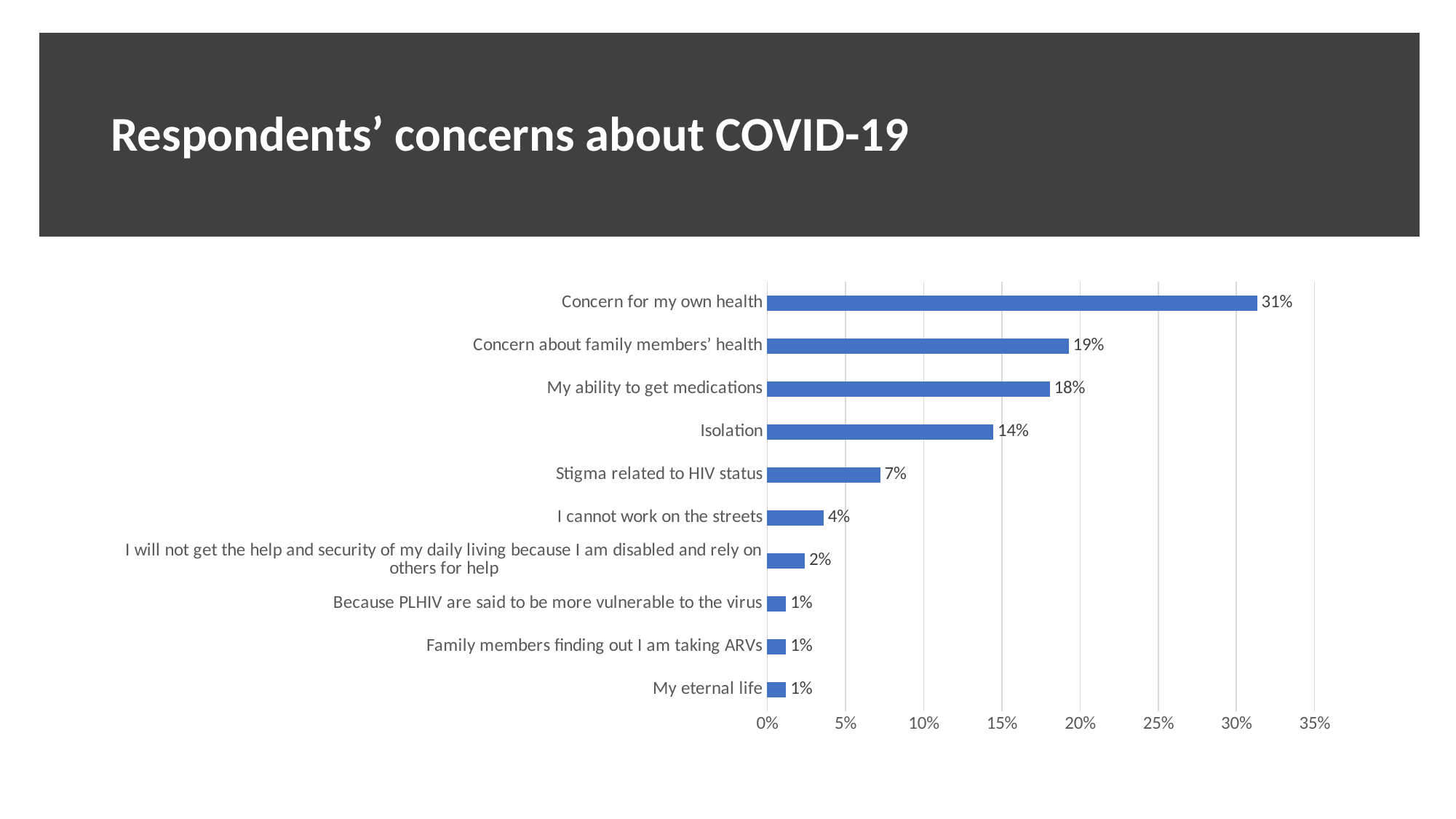
What is the value for 'Isolation'? 14% What is the difference between 'Concern for my own health' and 'Concern about family members' health'? 12% What type of chart is shown on the slide? Bar chart Which is larger: 'Stigma related to HIV status' or 'I cannot work on the streets'? Stigma related to HIV status Is the value for 'Concern for my own health' greater or less than 30%? greater How many concerns (categories) are shown in the chart? 10 Which concern has the highest value? Concern for my own health Is the value for 'Concern about family members' health' greater or less than 20%? less What percentage of respondents cited 'Concern for my own health'? 31% What is the value for 'Stigma related to HIV status'? 7% What is the difference between 'My ability to get medications' and 'Isolation'? 4% What is the title of the slide? Respondents' concerns about COVID-19